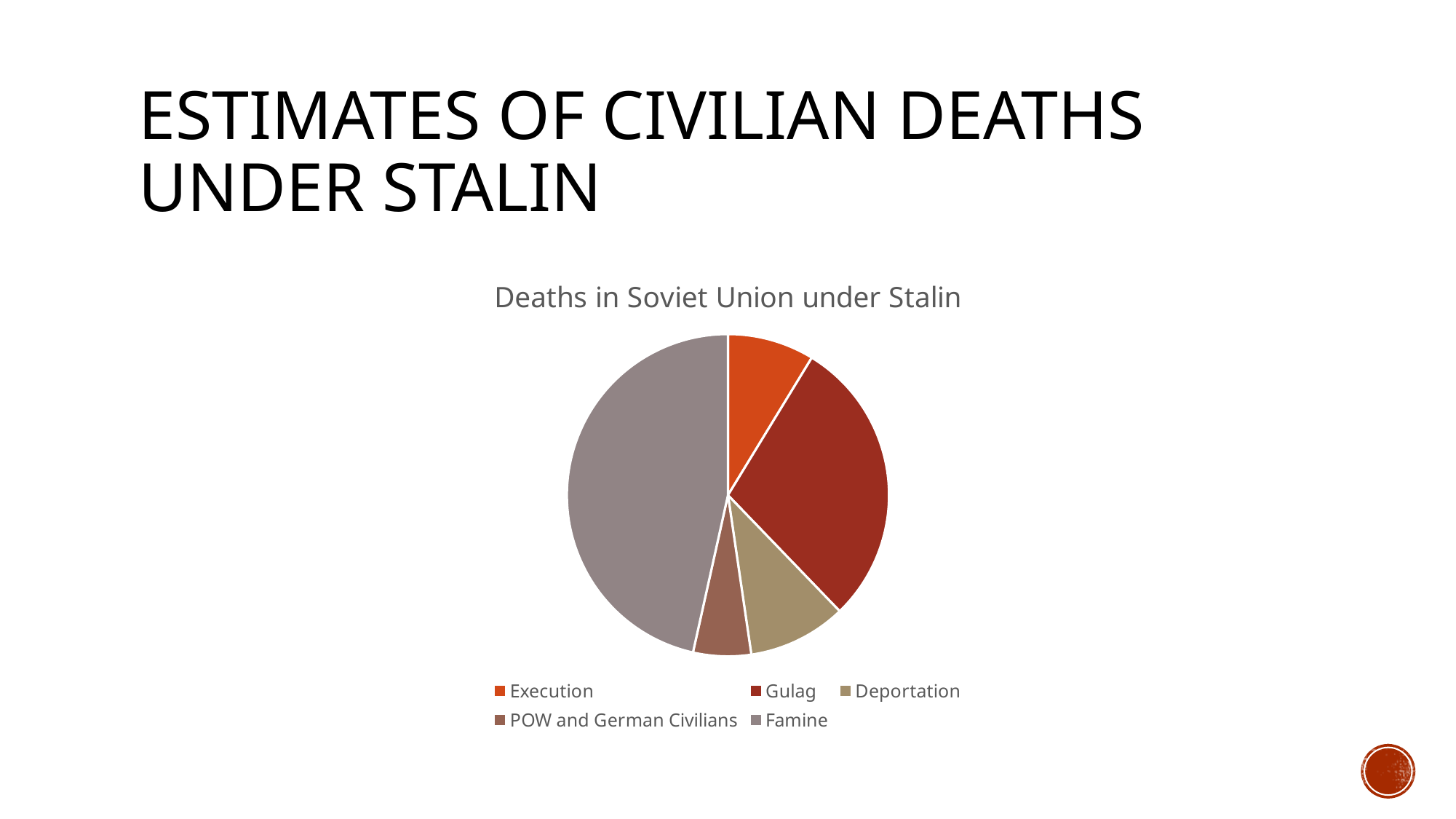
How many categories (slices) does the pie chart have? 5 Which is larger, the slice for Gulag or the slice for Deportation? Gulag Which is larger, the slice for Famine or the slice for POW and German Civilians? Famine What is the title of the chart? Deaths in Soviet Union under Stalin Which category has the largest slice of the pie? Famine How many entries does the legend list? 5 What kind of chart is shown on the slide? Pie chart Which category has the second-largest slice of the pie? Gulag Which category is shown in grey in the pie chart? Famine Which is larger, the slice for Gulag or the slice for Execution? Gulag